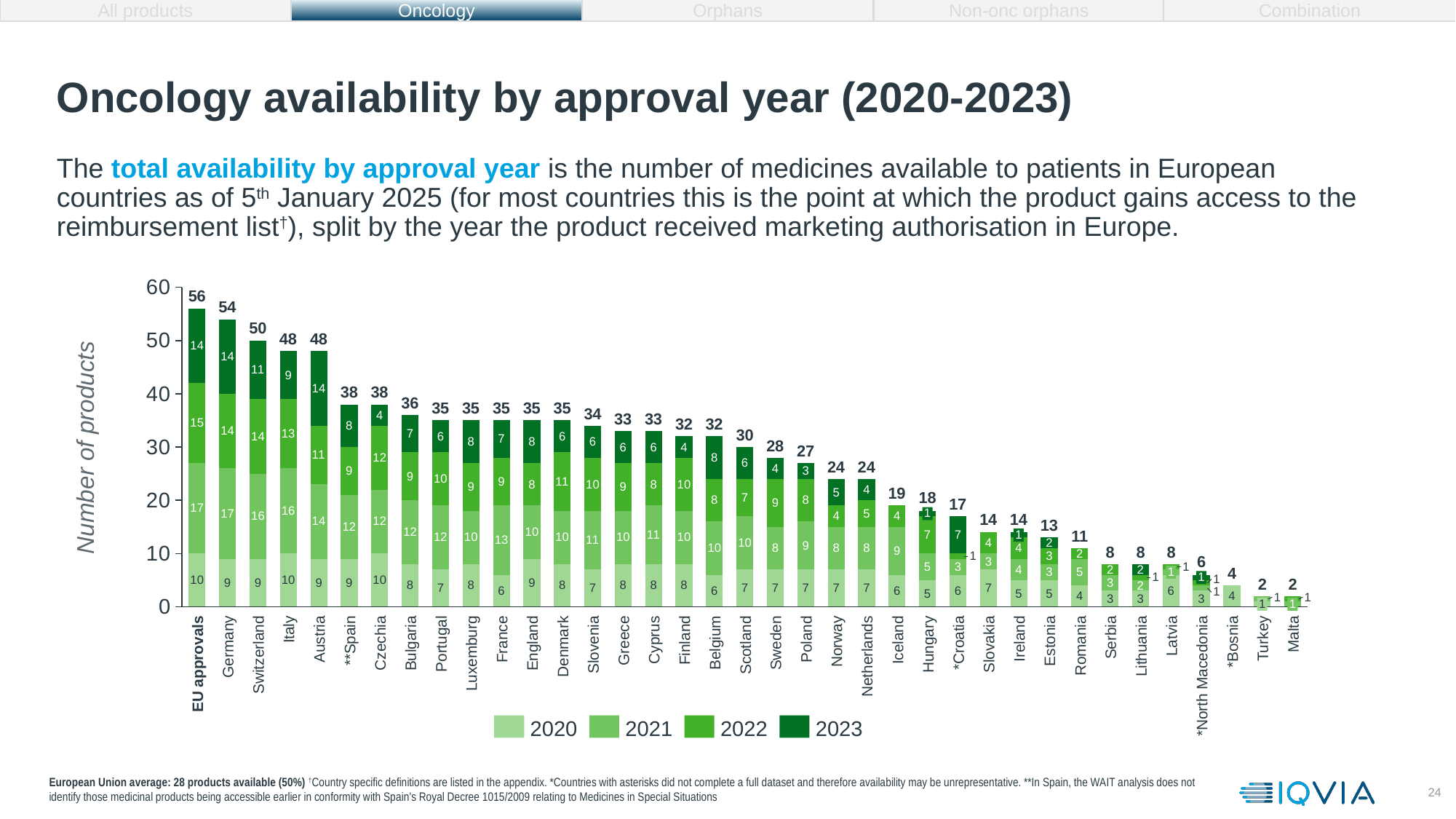
What kind of chart is shown on the slide? Stacked bar chart What is the total number of products for Poland? 27 Which category has the highest total number of products? EU approvals What is the difference between the totals for Germany and Switzerland? 4 How many categories (bars) are shown on the x axis? 37 How many products approved in 2023 are available in Czechia? 4 How many products approved in 2021 are available in Germany? 17 What is the label of the y axis? Number of products Is the total for Iceland greater or less than 20? less How many series does the legend list? 4 What is the total number of products for Germany? 54 Which has a higher total, Bulgaria or Slovenia? Bulgaria